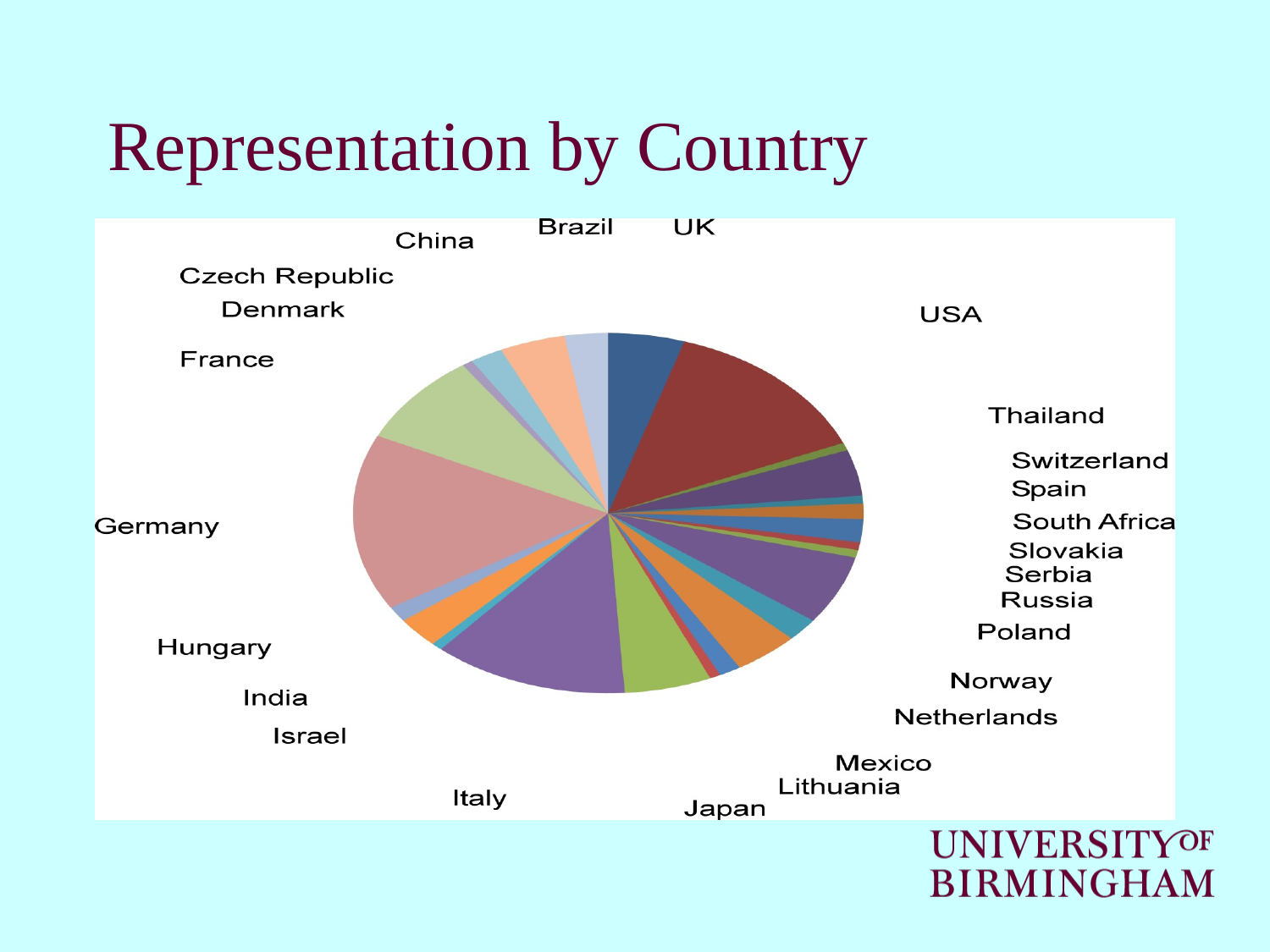
Which slice is larger, Italy or Japan? Italy How many countries are labelled on the pie chart? 25 Which slice is larger, Italy or Lithuania? Italy Which slice is larger, USA or Thailand? USA What kind of chart is shown on the slide? Pie chart What is the title of the slide containing the pie chart? Representation by Country What colour is the USA slice of the pie chart? Dark red